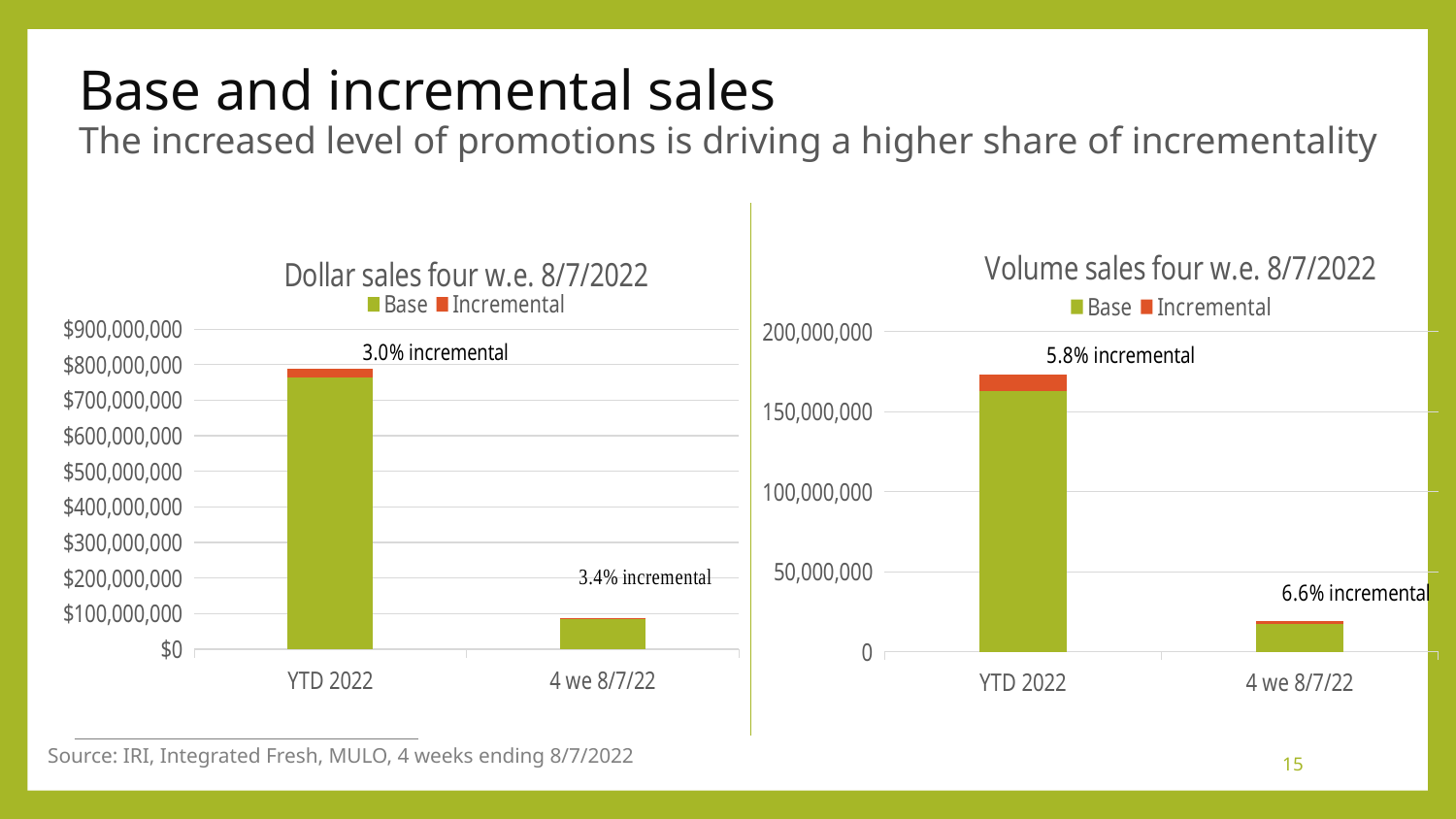
How many series does the legend of the 'Volume sales four w.e. 8/7/2022' chart list? 2 In the 'Dollar sales four w.e. 8/7/2022' chart, what incremental percentage is labelled for 4 we 8/7/22? 3.4% incremental In the 'Dollar sales four w.e. 8/7/2022' chart, is the total bar for 4 we 8/7/22 greater or less than $200,000,000? less In the 'Dollar sales four w.e. 8/7/2022' chart, is the total bar for YTD 2022 greater or less than $700,000,000? greater In the 'Volume sales four w.e. 8/7/2022' chart, what incremental percentage is labelled for YTD 2022? 5.8% incremental In the 'Volume sales four w.e. 8/7/2022' chart, is the total bar for 4 we 8/7/22 greater or less than 50,000,000? less In the 'Volume sales four w.e. 8/7/2022' chart, what incremental percentage is labelled for 4 we 8/7/22? 6.6% incremental What type of chart is the 'Dollar sales four w.e. 8/7/2022' chart? Stacked bar chart How many categories are shown on the x axis of the 'Volume sales four w.e. 8/7/2022' chart? 2 In the 'Dollar sales four w.e. 8/7/2022' chart, what incremental percentage is labelled for YTD 2022? 3.0% incremental In the 'Dollar sales four w.e. 8/7/2022' chart, which category has the taller bar, YTD 2022 or 4 we 8/7/22? YTD 2022